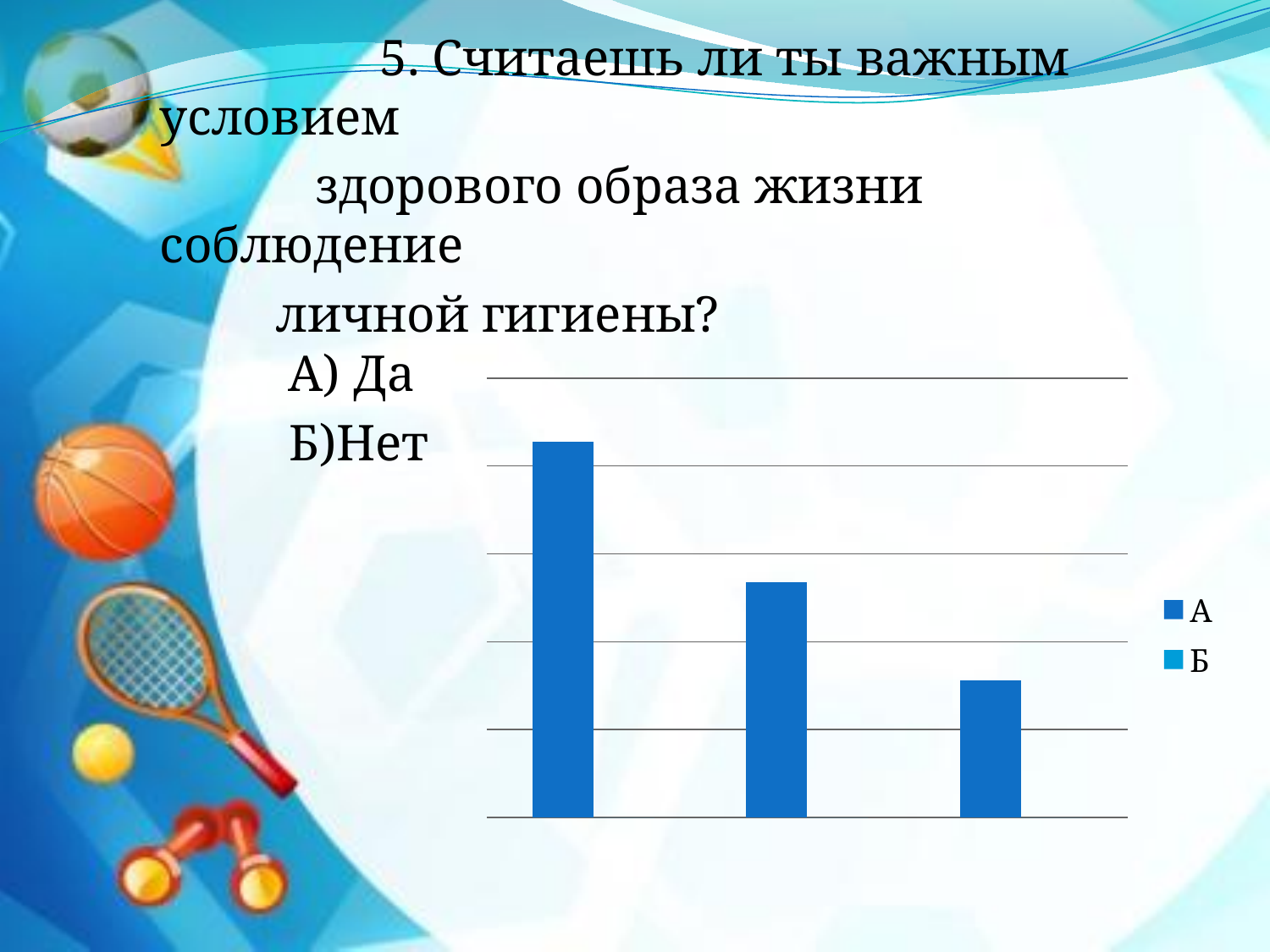
Is the middle bar taller or shorter than the leftmost bar? shorter Do the bar heights rise or fall from left to right across the chart? fall What colour are the bars in the chart? blue Which bar is the tallest: the leftmost, the middle, or the rightmost? leftmost What are the entries listed in the chart's legend? А and Б Which bar is the shortest: the leftmost, the middle, or the rightmost? rightmost Is the leftmost bar taller or shorter than the rightmost bar? taller How many bars are plotted in the chart? 3 What kind of chart is shown on the slide? bar chart How many entries does the chart's legend list? 2